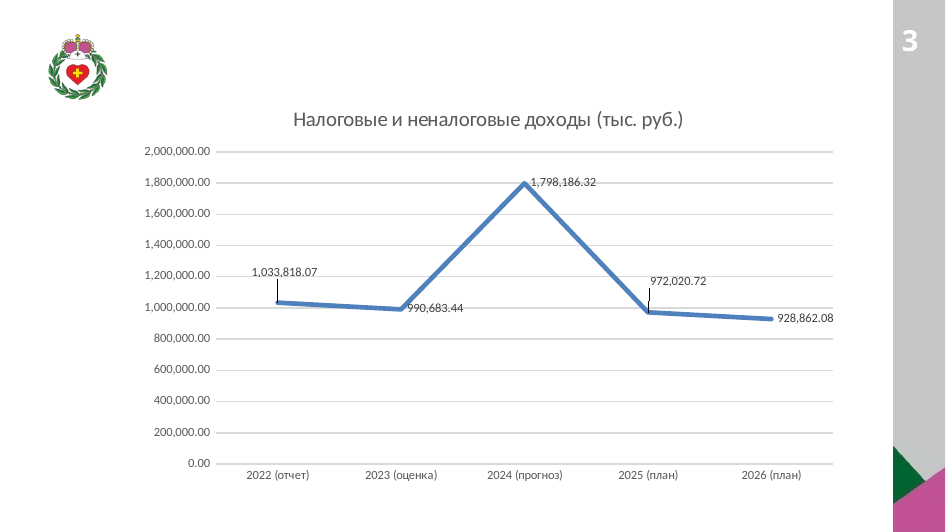
What is the difference between the values for 2024 (прогноз) and 2022 (отчет)? 764,368.25 Which category has the lowest value? 2026 (план) What is the value for 2022 (отчет)? 1,033,818.07 What is the difference between the values for 2025 (план) and 2026 (план)? 43,158.64 What is the value for 2026 (план)? 928,862.08 What is the title of the chart? Налоговые и неналоговые доходы (тыс. руб.) What is the value for 2024 (прогноз)? 1,798,186.32 Which is larger, the value for 2022 (отчет) or the value for 2025 (план)? 2022 (отчет) How many data points are plotted on the chart? 5 Which category has the highest value? 2024 (прогноз) What is the value for 2023 (оценка)? 990,683.44 What kind of chart is shown on the slide? Line chart